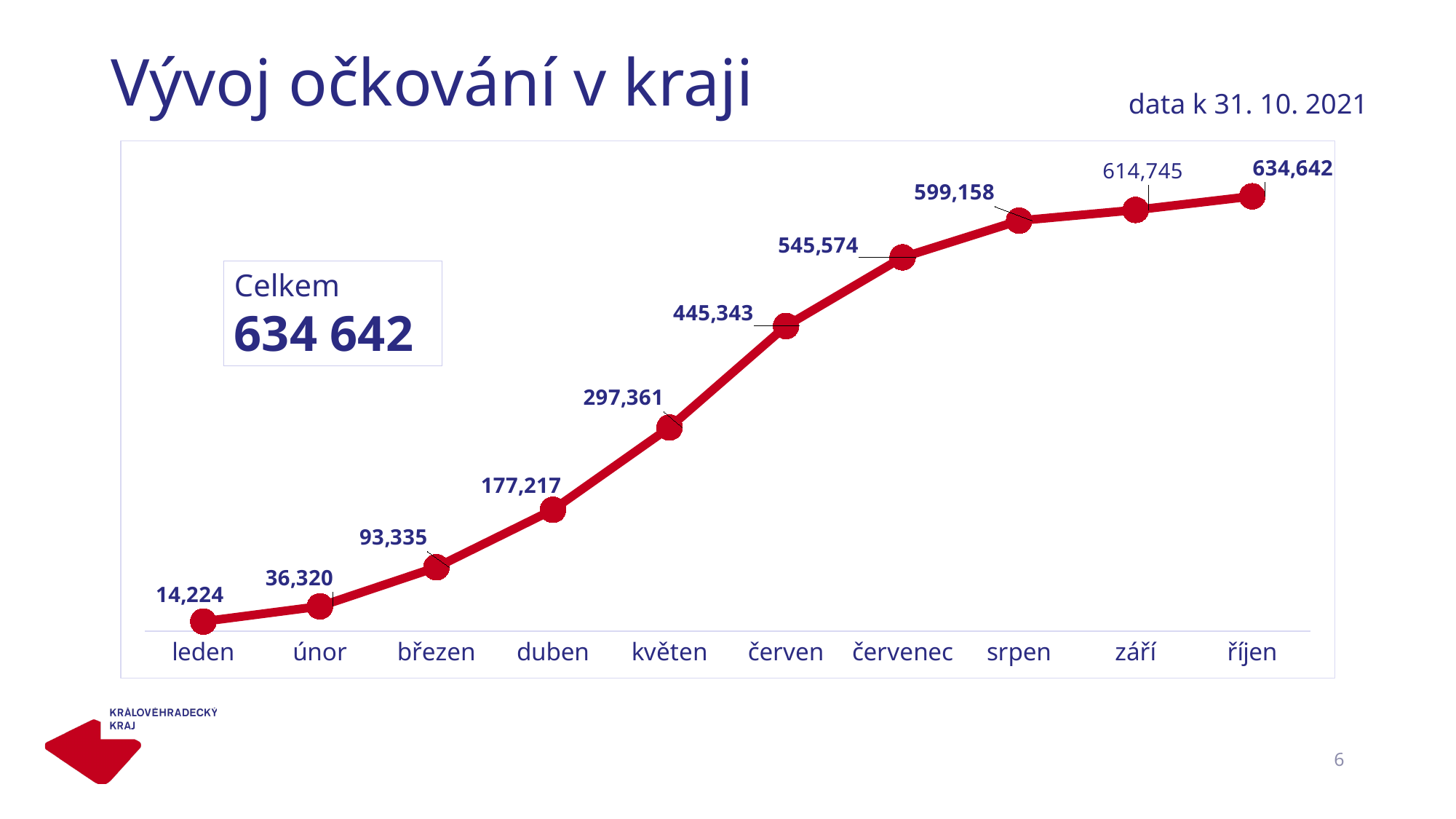
What is the value for červenec? 545,574 How many months are plotted on the chart? 10 Do the values rise or fall from leden to říjen? rise Which is larger, the value for březen or the value for únor? březen What is the title of the slide containing the chart? Vývoj očkování v kraji What is the value for leden? 14,224 What is the value for duben? 177,217 What is the difference between the values for květen and duben? 120,144 What is the difference between the values for říjen and září? 19,897 Which month has the lowest value? leden What kind of chart is shown on the slide? line chart Which month has the highest value? říjen